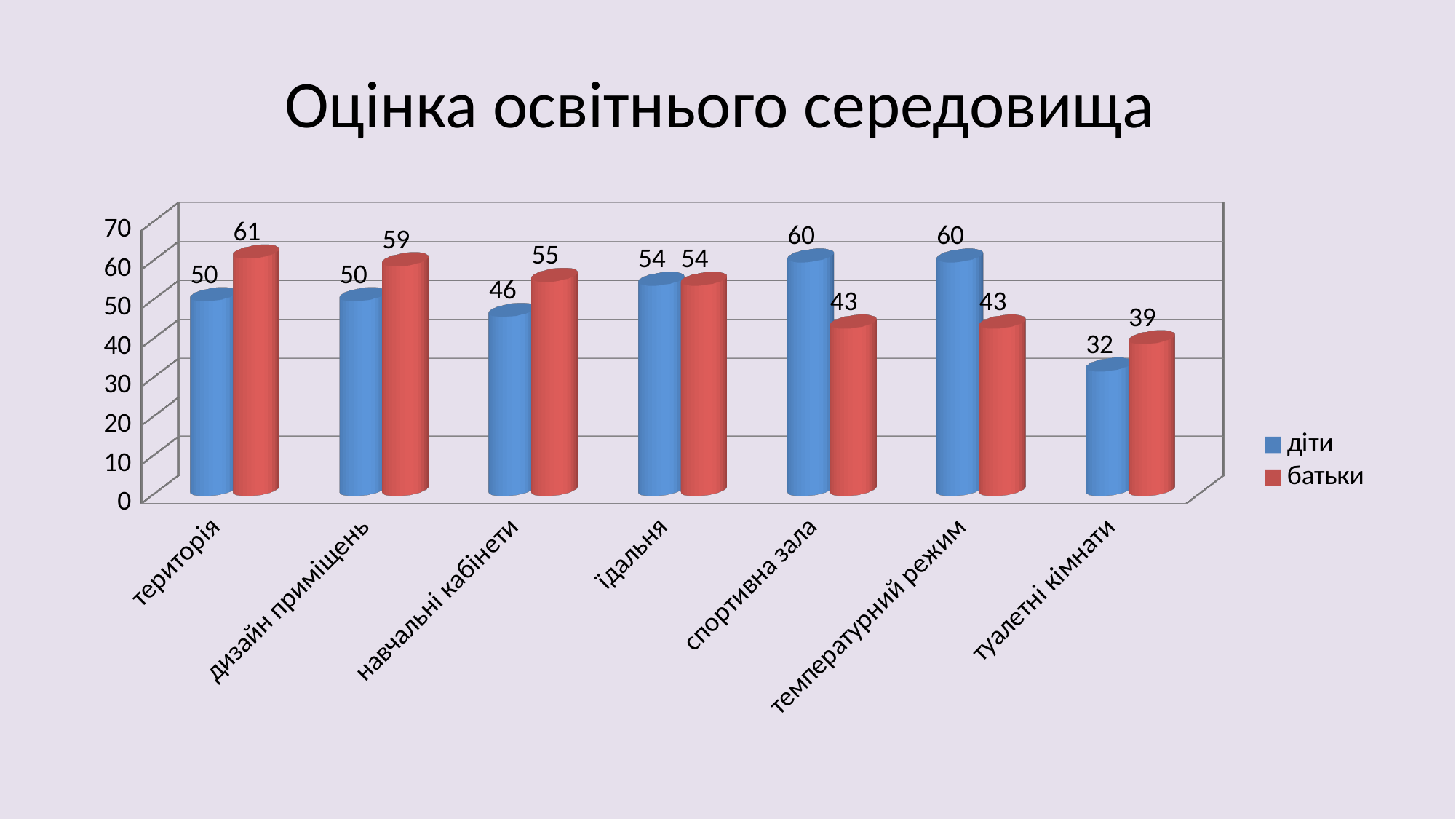
Which category has the highest value for батьки? територія What kind of chart is shown on the slide? bar chart How many series does the legend list? 2 How many categories are shown on the x axis? 7 What is the value for діти for територія? 50 What is the value for батьки for навчальні кабінети? 55 Which category has the lowest value for діти? туалетні кімнати What is the value for батьки for туалетні кімнати? 39 What is the difference between the батьки and діти values for спортивна зала? 17 Which is larger for навчальні кабінети: the value for діти or for батьки? батьки Is the value for діти for температурний режим greater or less than 50? greater What is the title of the chart? Оцінка освітнього середовища